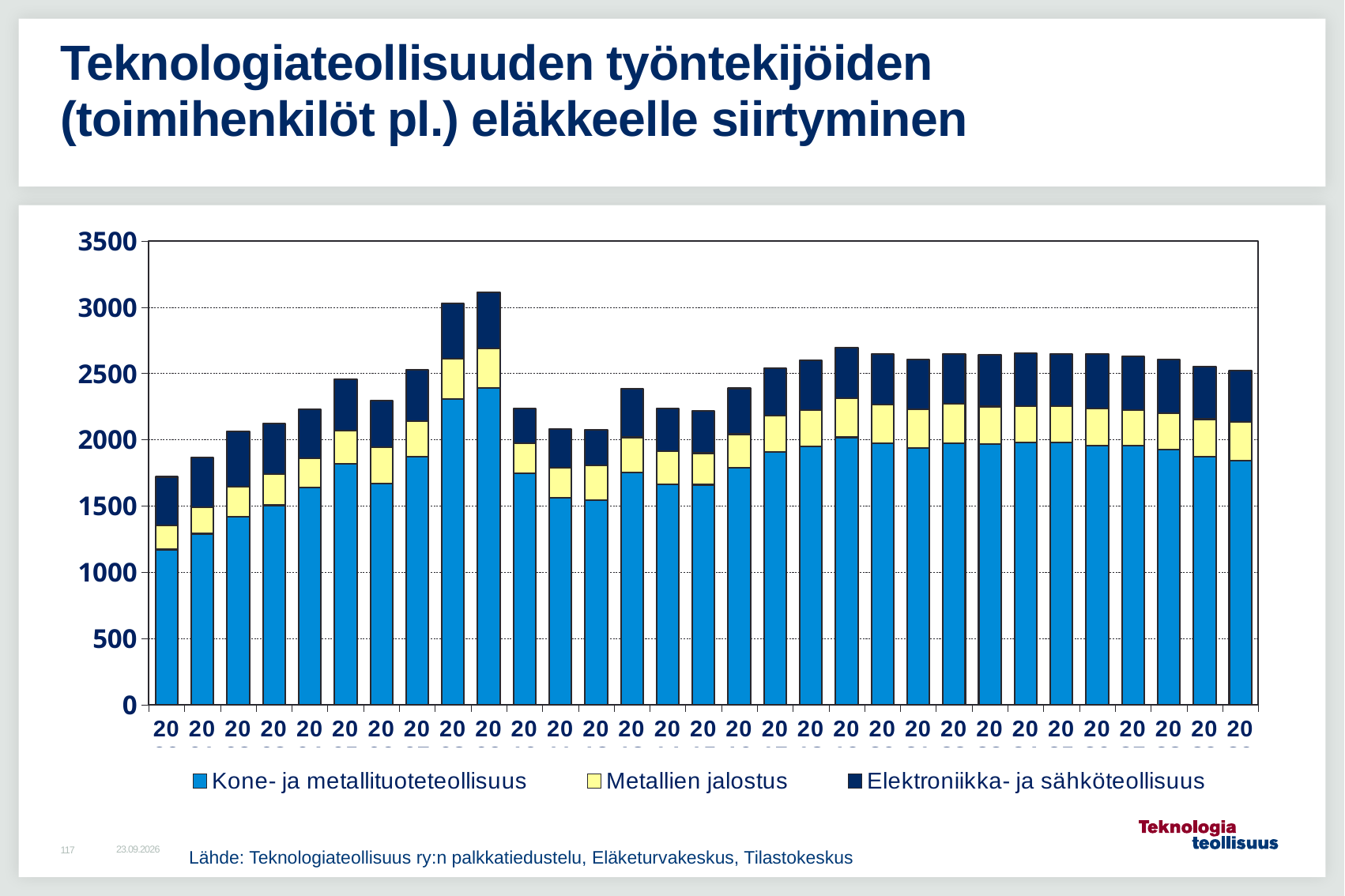
Is the total of the last (rightmost) bar greater or less than 2000? greater Which is taller, the first (leftmost) bar or the last (rightmost) bar? the last (rightmost) bar Which series is shown in light blue in the legend? Kone- ja metallituoteteollisuus Which series forms the largest segment in every bar? Kone- ja metallituoteteollisuus What kind of chart is shown on the slide? stacked bar chart How many series does the legend list? 3 Is the total of the tallest bar greater or less than 3000? greater Is the total of the first (leftmost) bar greater or less than 2000? less How many bars are plotted in the chart? 31 Which series is shown in yellow in the legend? Metallien jalostus What is the highest value shown on the vertical axis? 3500